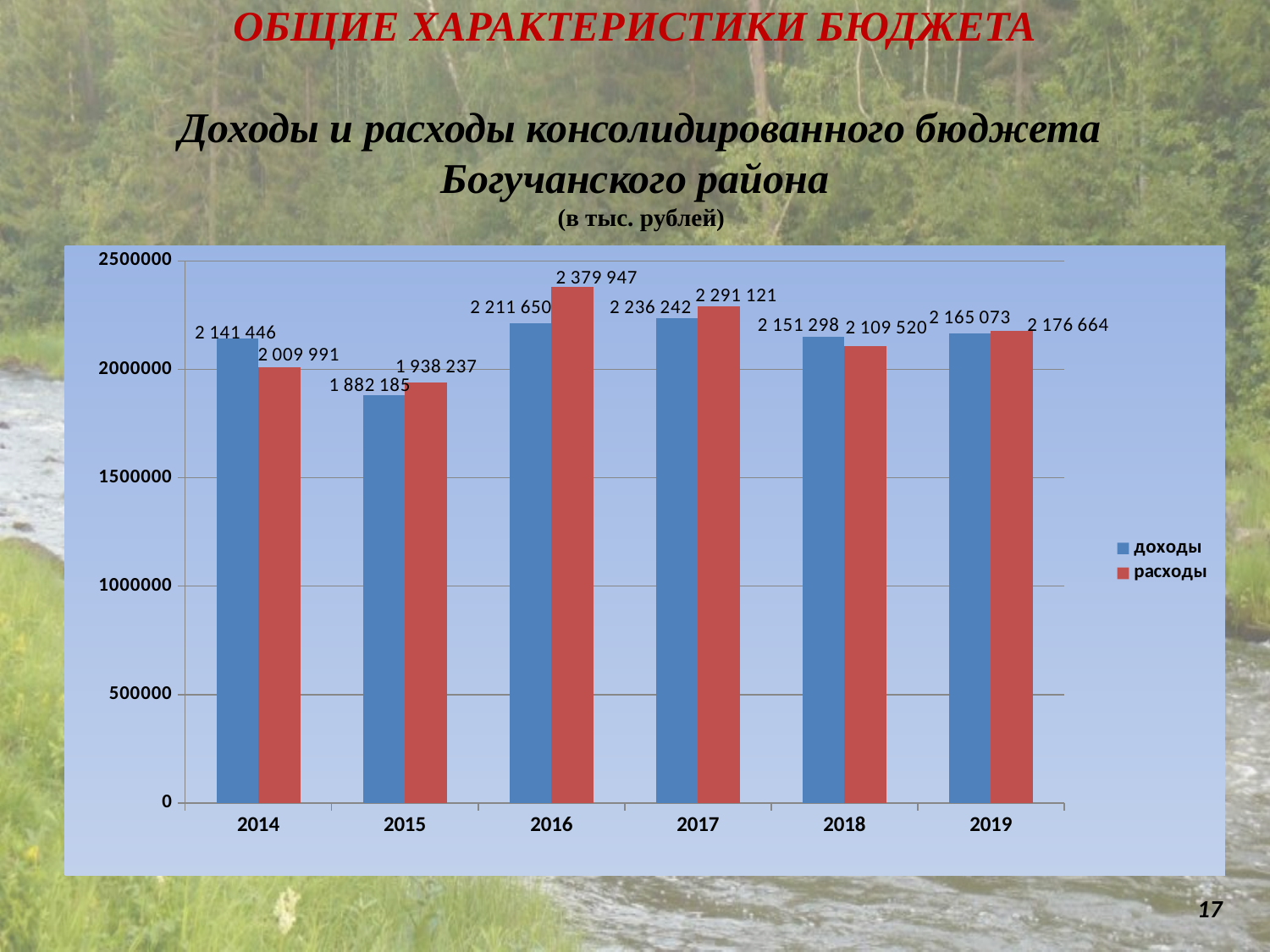
Is the value of доходы for 2015 greater or less than 2000000? less How many series does the legend list? 2 What is the value of расходы for 2015? 1 938 237 In which year is доходы the lowest? 2015 What is the value of расходы for 2019? 2 176 664 In which year is расходы the highest? 2016 What is the value of доходы for 2016? 2 211 650 What is the difference between доходы and расходы in 2014? 131 455 Which is larger in 2018, доходы or расходы? доходы What kind of chart is shown on the slide? bar chart How many years are shown on the x axis? 6 What is the difference between расходы and доходы in 2016? 168 297